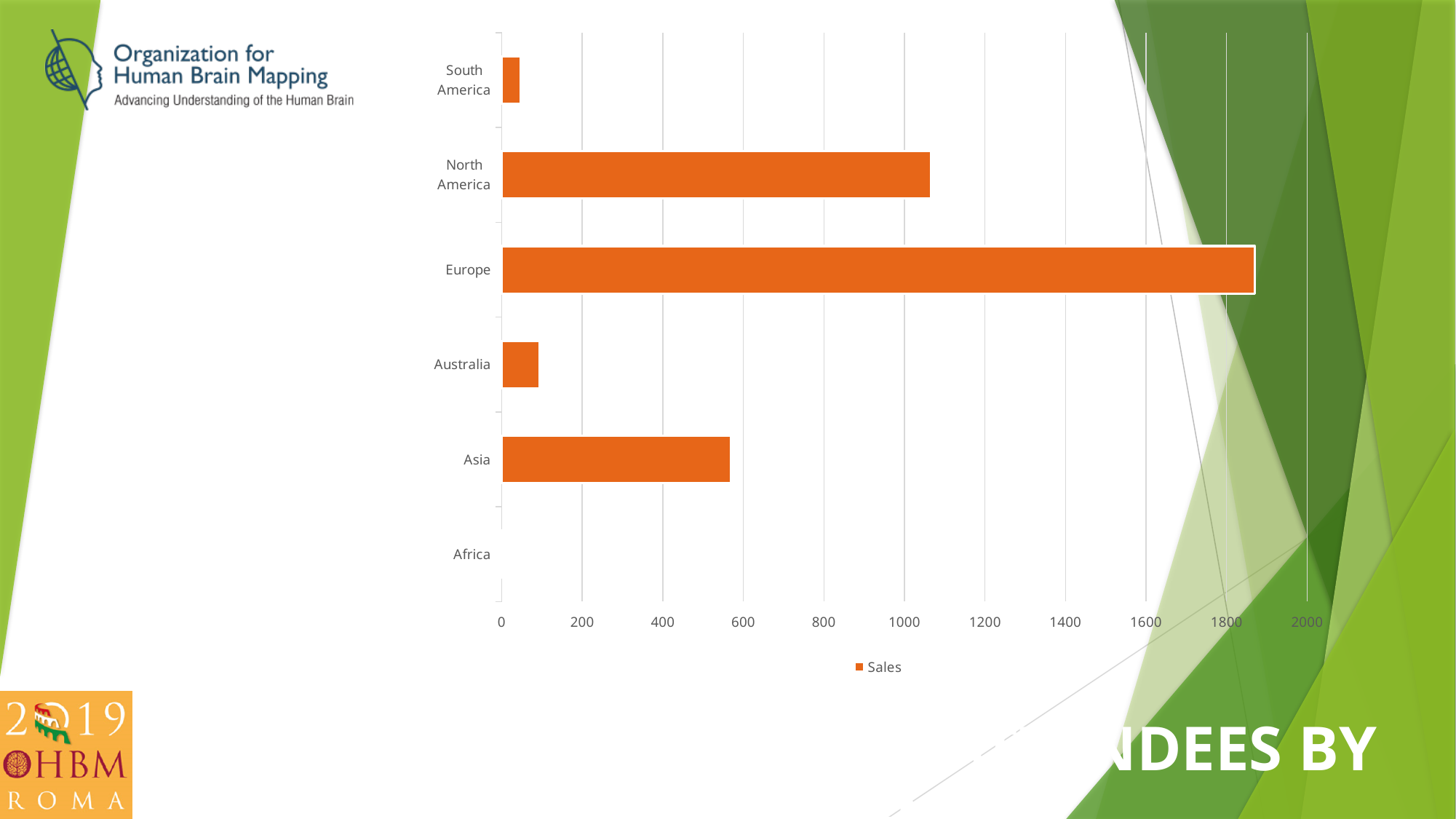
Which category has the lowest value? Africa Is the value for North America greater or less than 1000? greater Which category has the highest value? Europe Is the value for Asia greater or less than 600? less Is the value for Australia greater or less than 200? less How many series does the legend list? 1 Which is larger, the value for Australia or the value for South America? Australia What series name is shown in the legend? Sales How many categories are shown on the chart? 6 Which is larger, the value for North America or the value for Asia? North America What kind of chart is shown on the slide? bar chart